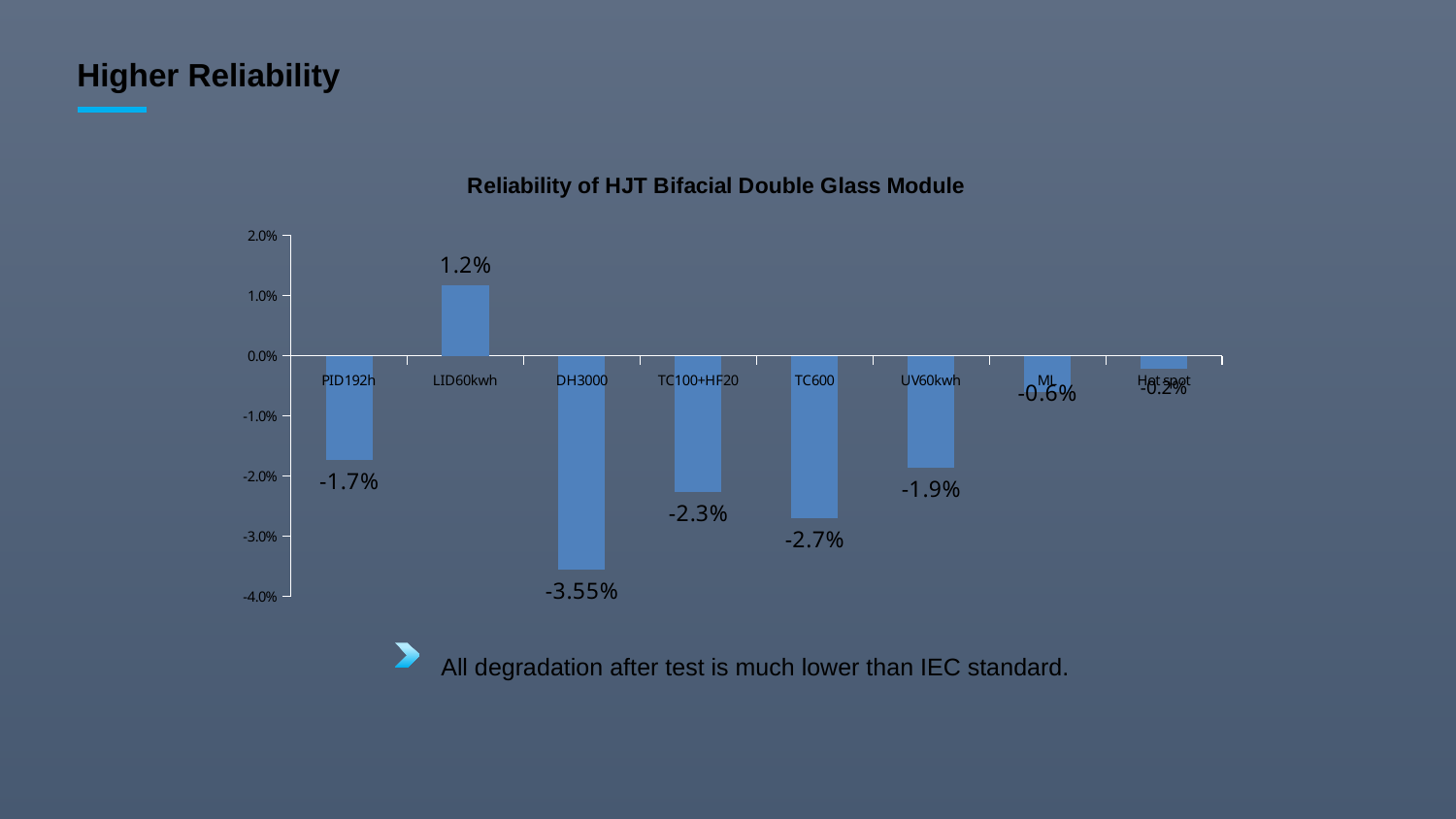
Which category has the highest value? LID60kwh Is the value for DH3000 greater or less than -3.0%? less What is the value for LID60kwh? 1.2% What kind of chart is this? bar chart What is the value for TC600? -2.7% How many categories are shown on the x axis? 8 What is the title of the chart? Reliability of HJT Bifacial Double Glass Module What is the value for UV60kwh? -1.9% What is the value for DH3000? -3.55% Which has the larger value, PID192h or ML? ML Which category has the lowest value? DH3000 What is the difference between the values for TC600 and TC100+HF20? 0.4%